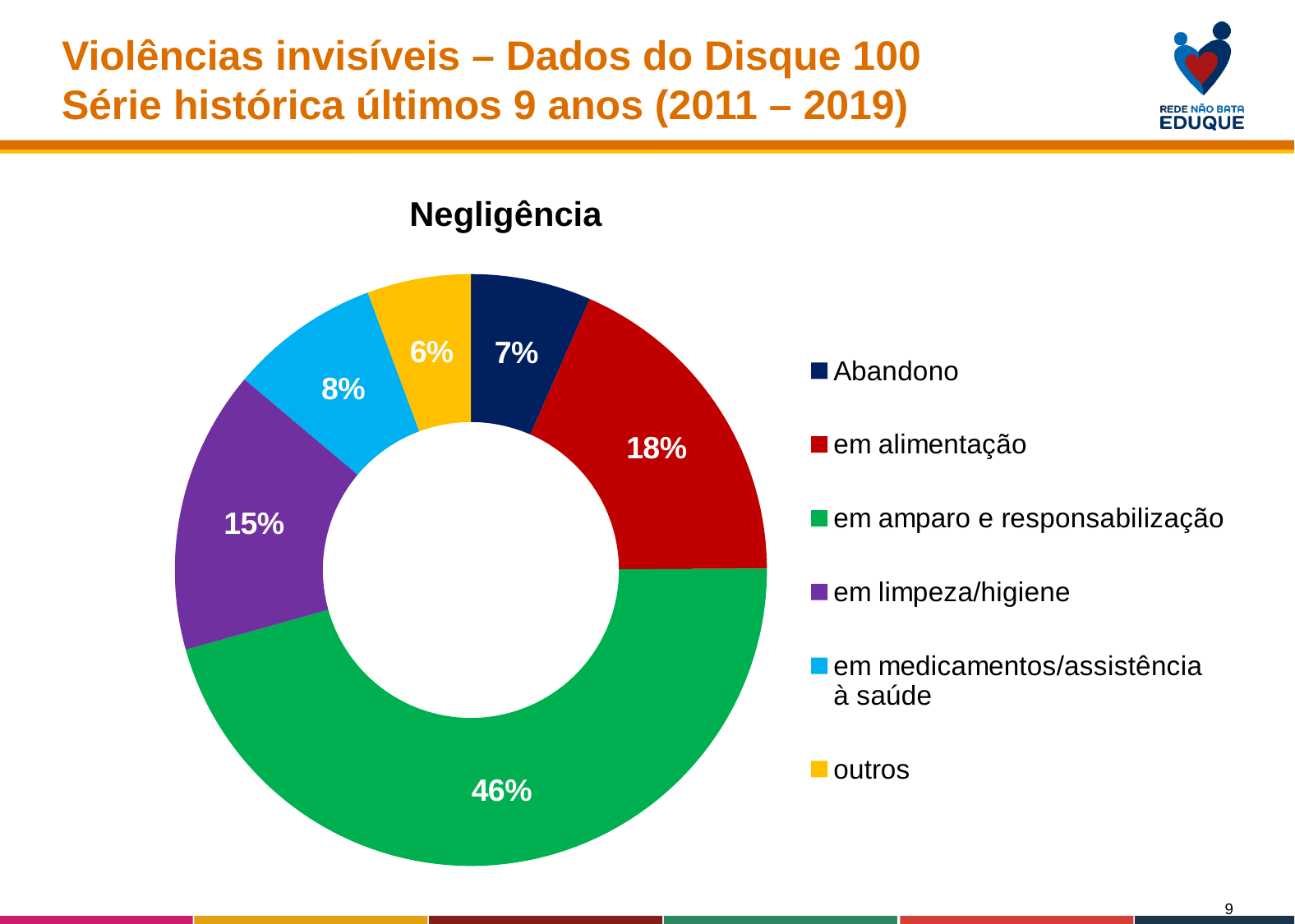
What share does 'em amparo e responsabilização' have in the chart? 46% How many categories does the legend list? 6 What is the difference between the shares of 'em alimentação' and 'em limpeza/higiene'? 3% What is the value for 'em alimentação'? 18% Which category has the smallest share? outros What is the value for 'em medicamentos/assistência à saúde'? 8% What kind of chart is shown on the slide? Doughnut chart Which category has the largest share? em amparo e responsabilização What is the title of the chart? Negligência What is the value for 'em limpeza/higiene'? 15% Which is larger, the share for 'Abandono' or the share for 'em medicamentos/assistência à saúde'? em medicamentos/assistência à saúde What is the value for 'Abandono'? 7%